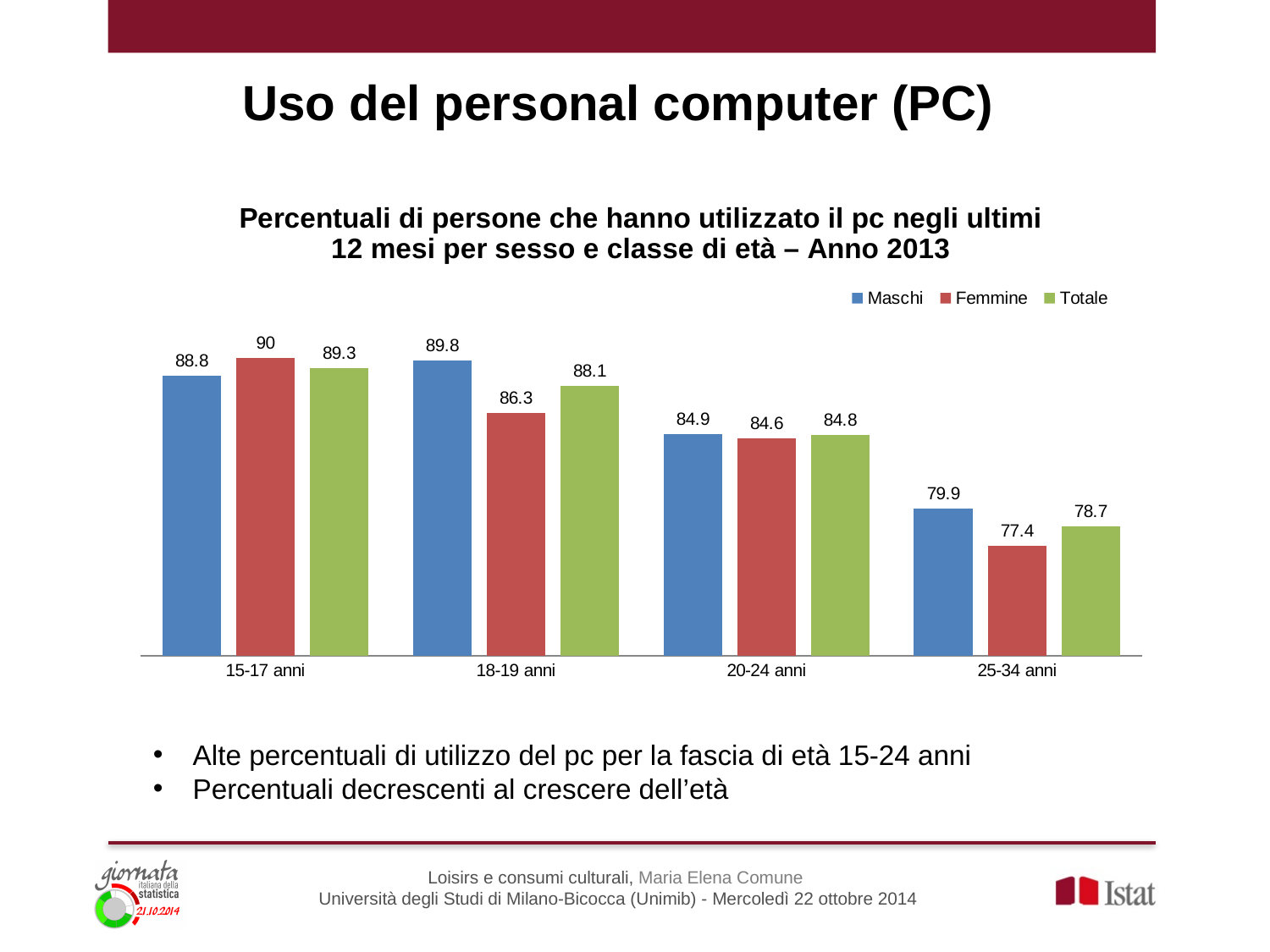
How many age groups are shown on the x axis? 4 What kind of chart is shown on the slide? Bar chart Which age group has the highest value for Femmine? 15-17 anni Do the Totale values rise or fall as the age groups increase along the x axis? Fall How many series does the legend list? 3 Which age group has the lowest value for Totale? 25-34 anni What is the value for Totale in the 18-19 anni age group? 88.1 What is the value for Femmine in the 25-34 anni age group? 77.4 What is the value for Maschi in the 15-17 anni age group? 88.8 What is the difference between the Maschi and Femmine values in the 18-19 anni age group? 3.5 Which series is shown in green in the legend? Totale Which is larger in the 15-17 anni age group, the Maschi value or the Femmine value? Femmine